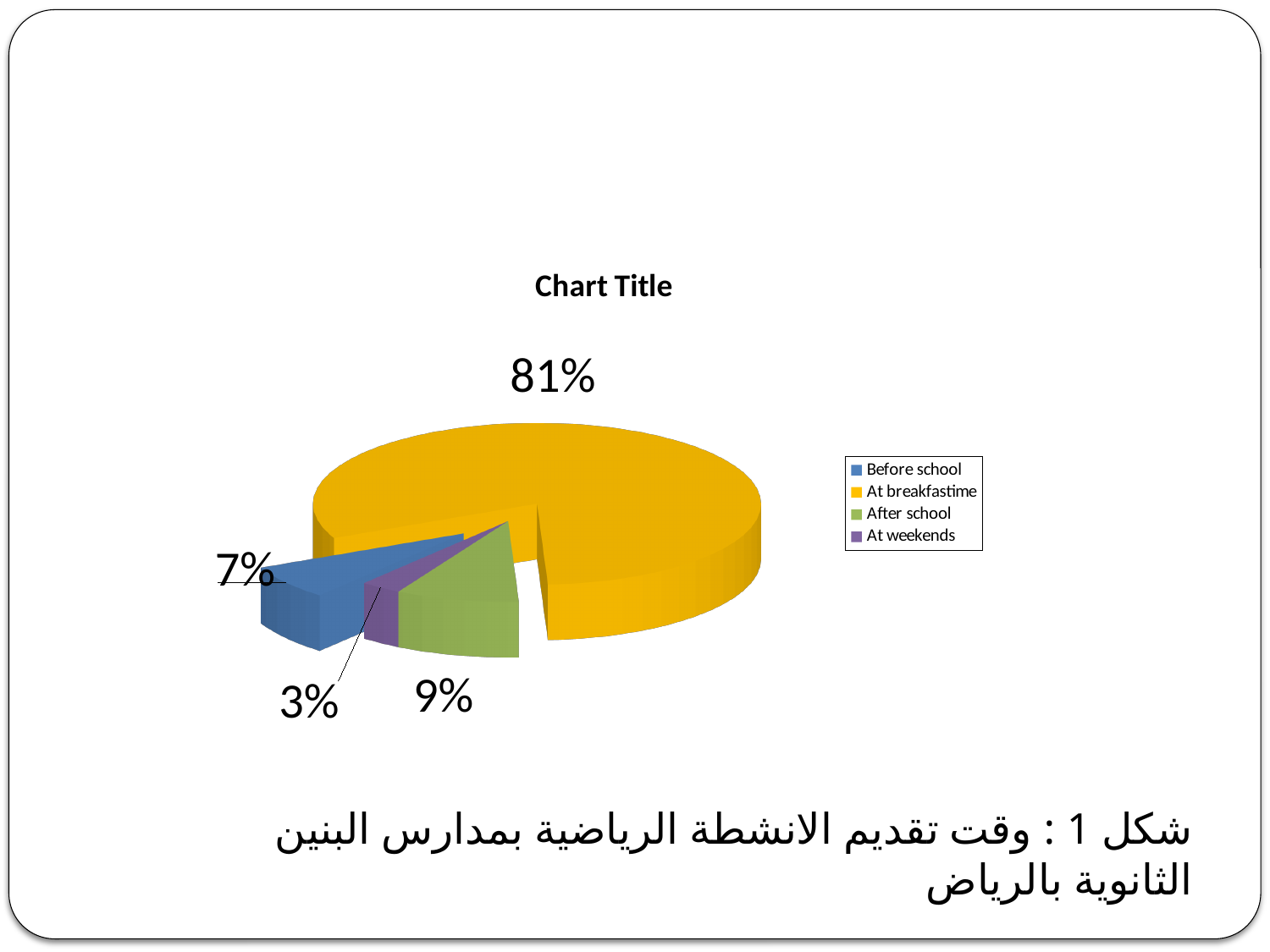
What colour is the slice for At weekends? Purple What percentage of the pie is labelled for Before school? 7% What percentage of the pie is labelled for At breakfastime? 81% What is the title shown above the pie chart? Chart Title Which category has the largest slice of the pie? At breakfastime What percentage of the pie is labelled for At weekends? 3% How many categories does the legend list? 4 What is the difference in percentage points between the At breakfastime slice and the After school slice? 72 What percentage of the pie is labelled for After school? 9% Which is larger, the slice for After school or the slice for Before school? After school Which category has the smallest slice of the pie? At weekends What kind of chart is shown on the slide? Pie chart